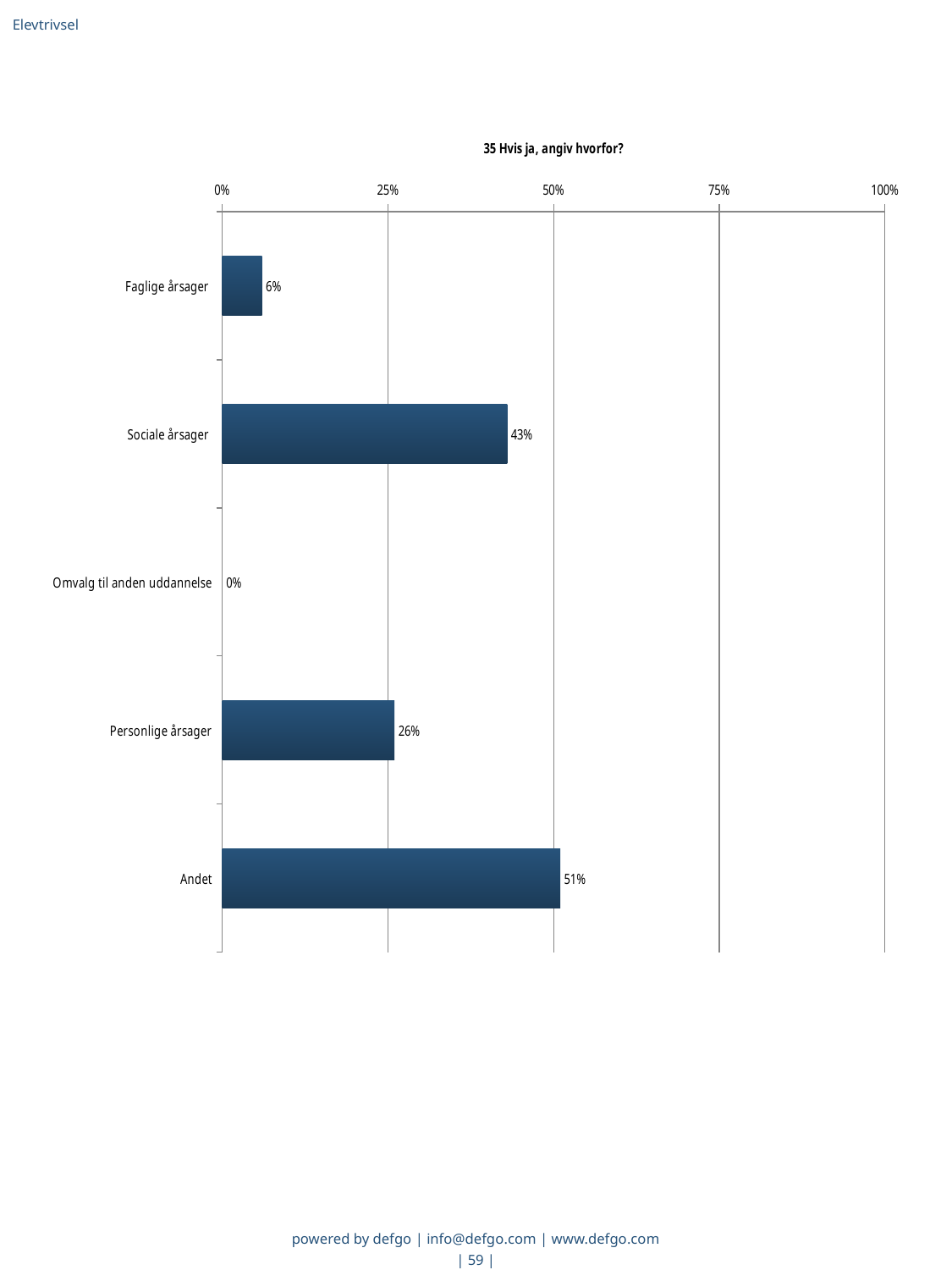
What is the value for Sociale årsager? 43% What is the value for Faglige årsager? 6% Is the value for Andet greater or less than 50%? greater What is the value for Omvalg til anden uddannelse? 0% What is the title of the chart? 35 Hvis ja, angiv hvorfor? Which category has the lowest value? Omvalg til anden uddannelse What is the value for Personlige årsager? 26% What is the difference between the values for Andet and Sociale årsager? 8% Which category has the highest value? Andet Which is larger, the value for Personlige årsager or the value for Faglige årsager? Personlige årsager How many categories are shown in the chart? 5 What kind of chart is shown on the slide? bar chart